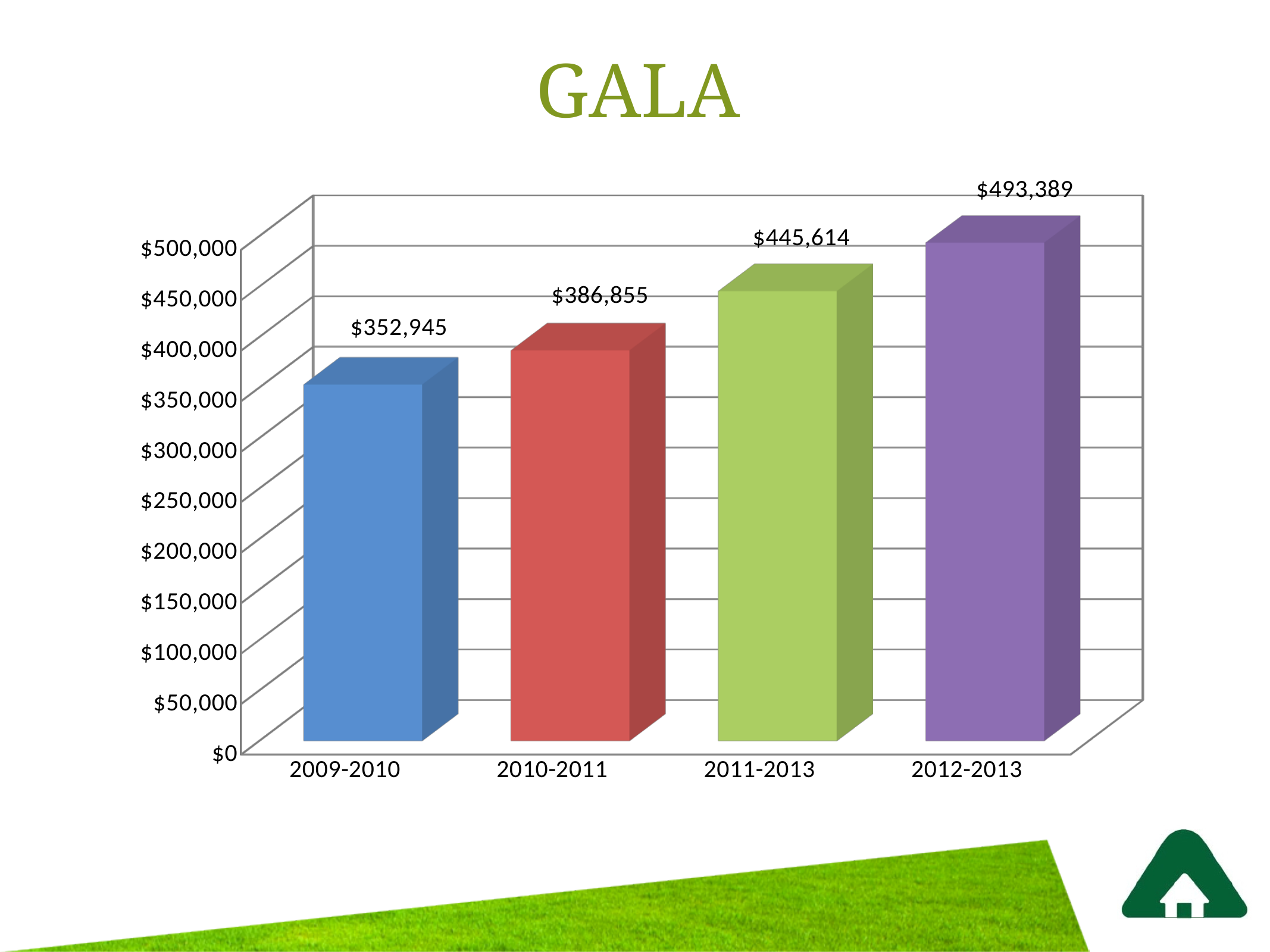
What is the value for 2012-2013? $493,389 What is the value for 2010-2011? $386,855 Which is larger, the value for 2010-2011 or the value for 2011-2013? 2011-2013 What is the difference between the values for 2011-2013 and 2010-2011? $58,759 What is the value for 2009-2010? $352,945 Do the values rise or fall from 2009-2010 to 2012-2013? Rise Which category has the lowest value? 2009-2010 What kind of chart is shown on the slide? Bar chart Which category has the highest value? 2012-2013 What is the value for 2011-2013? $445,614 How many categories are shown on the x axis? 4 What is the difference between the values for 2012-2013 and 2009-2010? $140,444